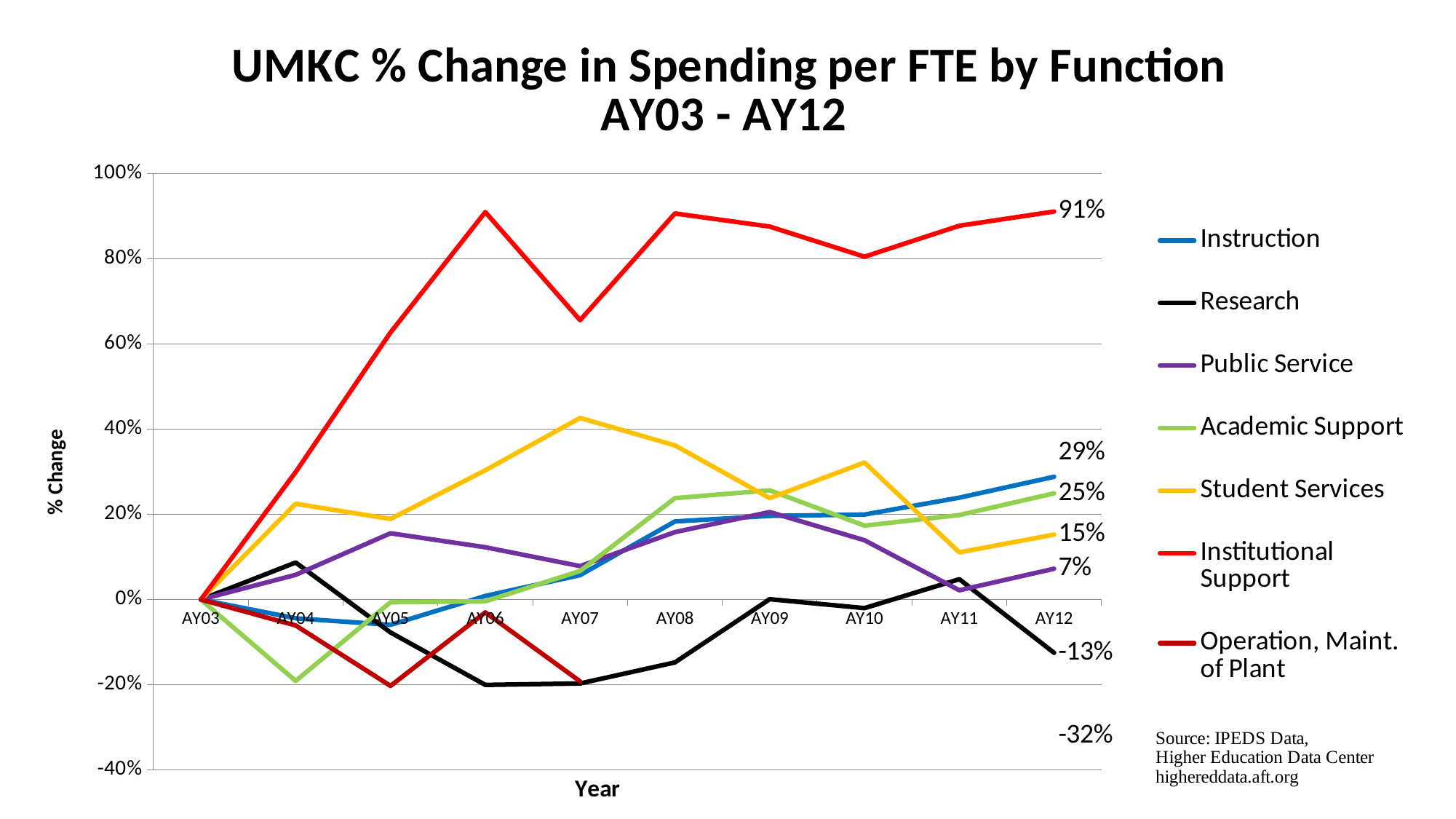
Does the Institutional Support line rise or fall from AY03 to AY06? rises What kind of chart is shown on the slide? line chart What is the difference between the AY12 values for Instruction and Academic Support? 4% Is the value for Institutional Support in AY06 greater or less than 80%? greater What is the value for Research in AY12? -13% In AY12, which is larger: Student Services or Public Service? Student Services What is the value for Institutional Support in AY12? 91% Which function has the highest value in AY12? Institutional Support How many years are shown on the x axis? 10 What is the value for Instruction in AY12? 29% What is the value for Academic Support in AY12? 25% How many series does the legend list? 7